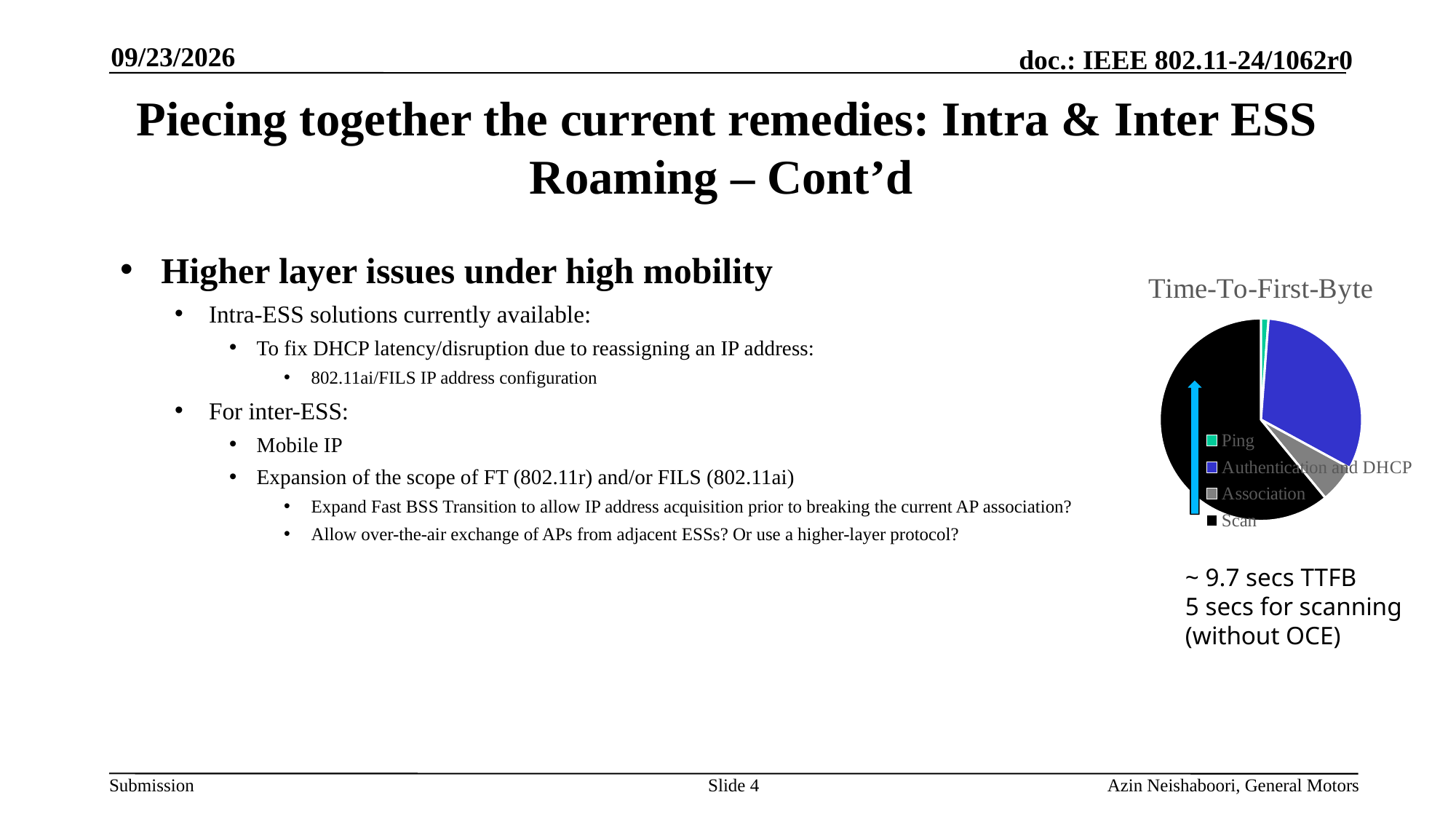
Which category has the largest slice in the Time-To-First-Byte pie chart? Scan Which category has the smallest slice in the Time-To-First-Byte pie chart? Ping What kind of chart is shown on the slide? pie chart How many categories does the pie chart's legend list? 4 In the Time-To-First-Byte pie chart, which slice is larger: Scan or Authentication and DHCP? Scan In the Time-To-First-Byte pie chart, which slice is larger: Authentication and DHCP or Association? Authentication and DHCP What colour is the Scan slice in the Time-To-First-Byte pie chart? black In the Time-To-First-Byte pie chart, which slice is larger: Association or Ping? Association What is the title of the chart on the slide? Time-To-First-Byte